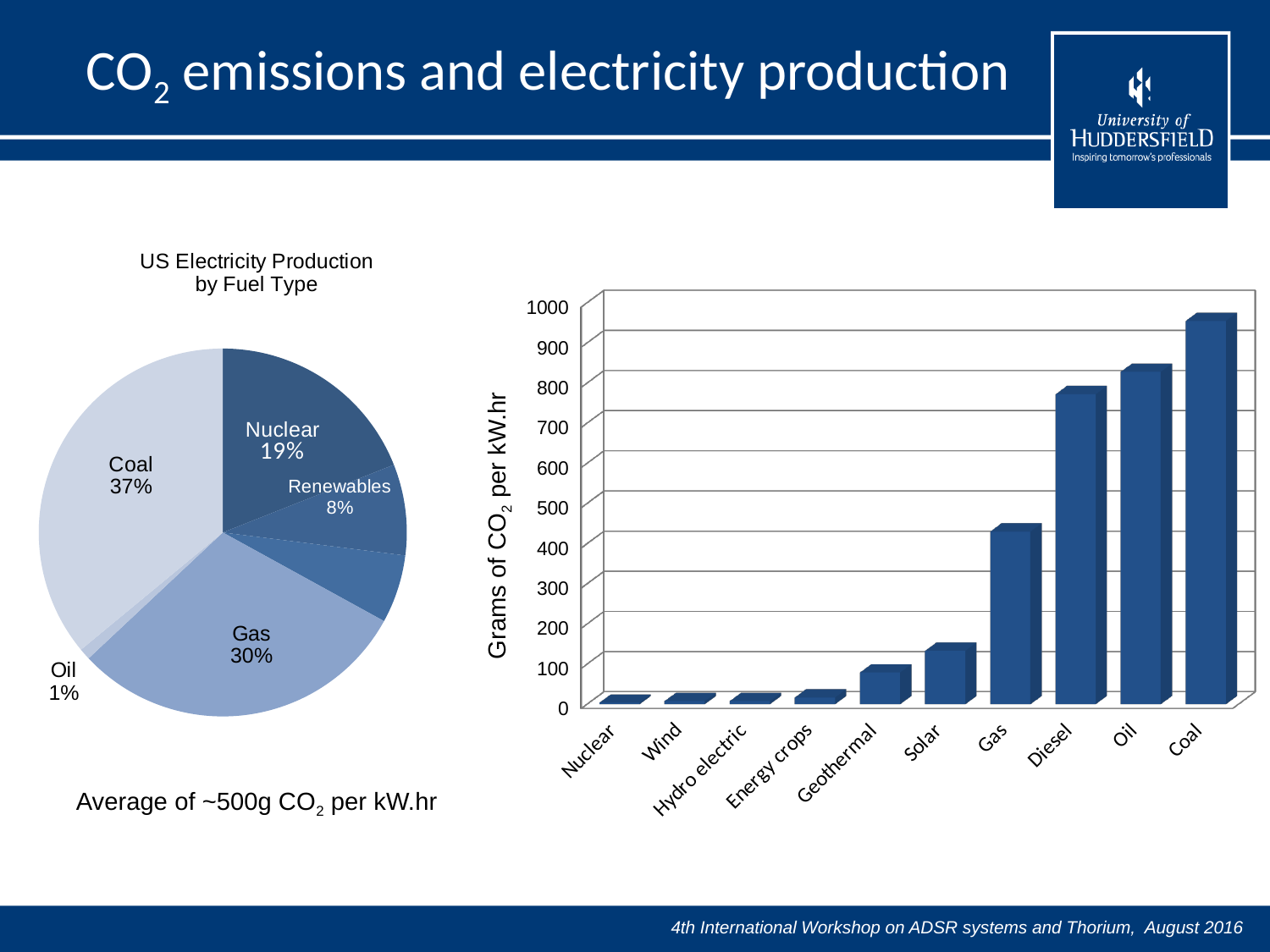
In the pie chart 'US Electricity Production by Fuel Type', which has the larger share, Nuclear or Renewables? Nuclear In the pie chart 'US Electricity Production by Fuel Type', which labelled fuel type has the largest share? Coal In the bar chart on the right, which energy source has the highest grams of CO2 per kW.hr? Coal In the bar chart on the right, how many energy sources are shown on the x axis? 10 In the pie chart 'US Electricity Production by Fuel Type', what share does Coal have? 37% In the pie chart 'US Electricity Production by Fuel Type', what share does Oil have? 1% In the bar chart on the right, do the values rise or fall from left to right along the x axis? Rise In the bar chart on the right, is the value for Gas greater or less than 500? less In the pie chart 'US Electricity Production by Fuel Type', what share does Gas have? 30% What kind of chart is the chart on the right of the slide? Bar chart In the pie chart 'US Electricity Production by Fuel Type', what share does Nuclear have? 19% In the pie chart 'US Electricity Production by Fuel Type', how many percentage points larger is Coal's share than Gas's share? 7